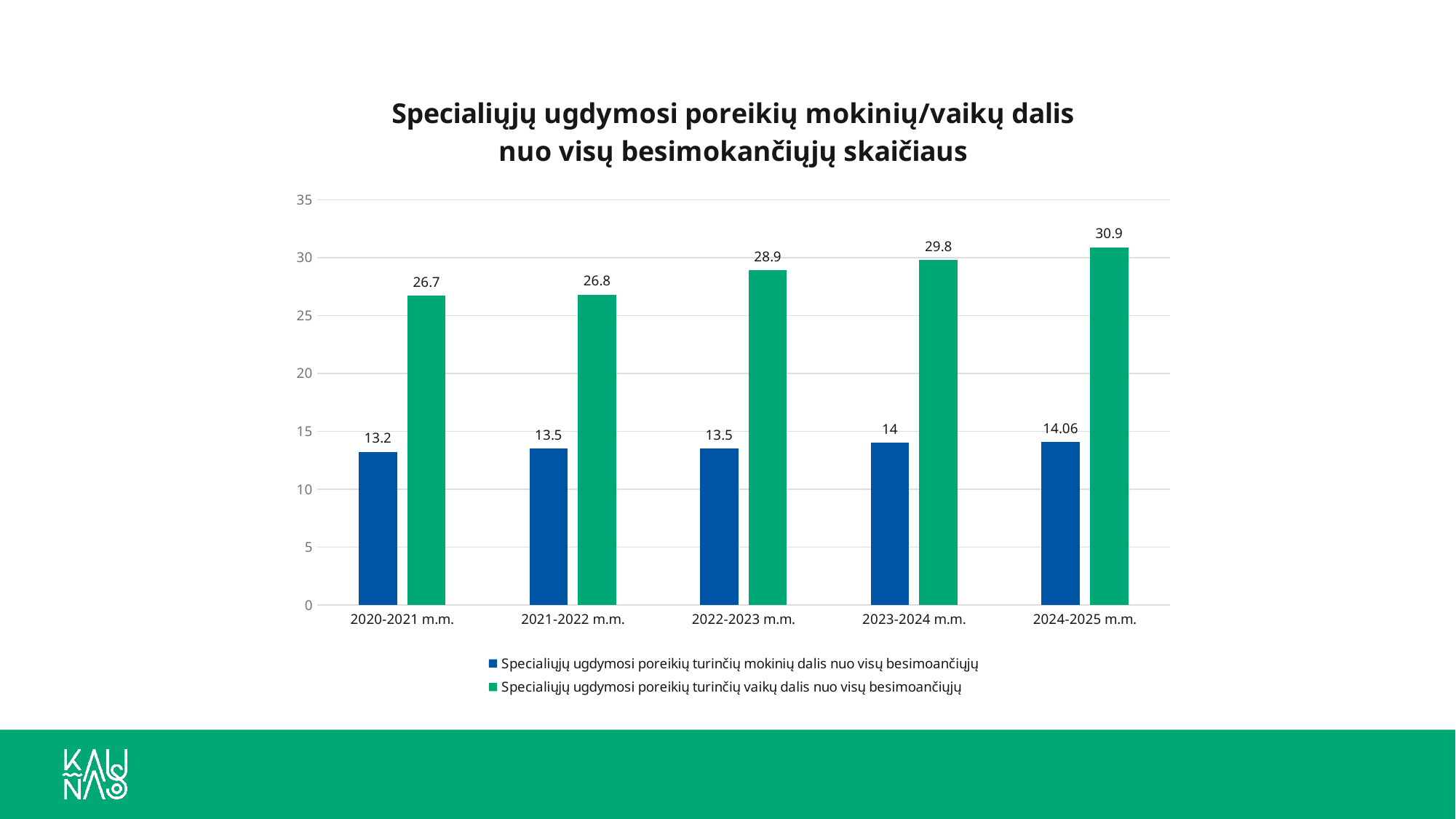
What is the difference between the 'vaikų dalis' value and the 'mokinių dalis' value in 2022-2023 m.m.? 15.4 Which is larger in 2023-2024 m.m.: the 'mokinių dalis' value or the 'vaikų dalis' value? Specialiųjų ugdymosi poreikių turinčių vaikų dalis nuo visų besimoančiųjų How many school years are shown on the x axis? 5 Is the 'vaikų dalis' value for 2024-2025 m.m. greater or less than 30? greater In which school year is the 'Specialiųjų ugdymosi poreikių turinčių mokinių dalis nuo visų besimoančiųjų' value lowest? 2020-2021 m.m. What is the value for 'Specialiųjų ugdymosi poreikių turinčių vaikų dalis nuo visų besimoančiųjų' in 2024-2025 m.m.? 30.9 What is the value for 'Specialiųjų ugdymosi poreikių turinčių mokinių dalis nuo visų besimoančiųjų' in 2020-2021 m.m.? 13.2 What is the value for 'Specialiųjų ugdymosi poreikių turinčių mokinių dalis nuo visų besimoančiųjų' in 2024-2025 m.m.? 14.06 What kind of chart is shown on the slide? bar chart Do the 'Specialiųjų ugdymosi poreikių turinčių vaikų dalis nuo visų besimoančiųjų' values rise or fall from 2020-2021 m.m. to 2024-2025 m.m.? rise How many series does the legend list? 2 In which school year is the 'Specialiųjų ugdymosi poreikių turinčių vaikų dalis nuo visų besimoančiųjų' value highest? 2024-2025 m.m.